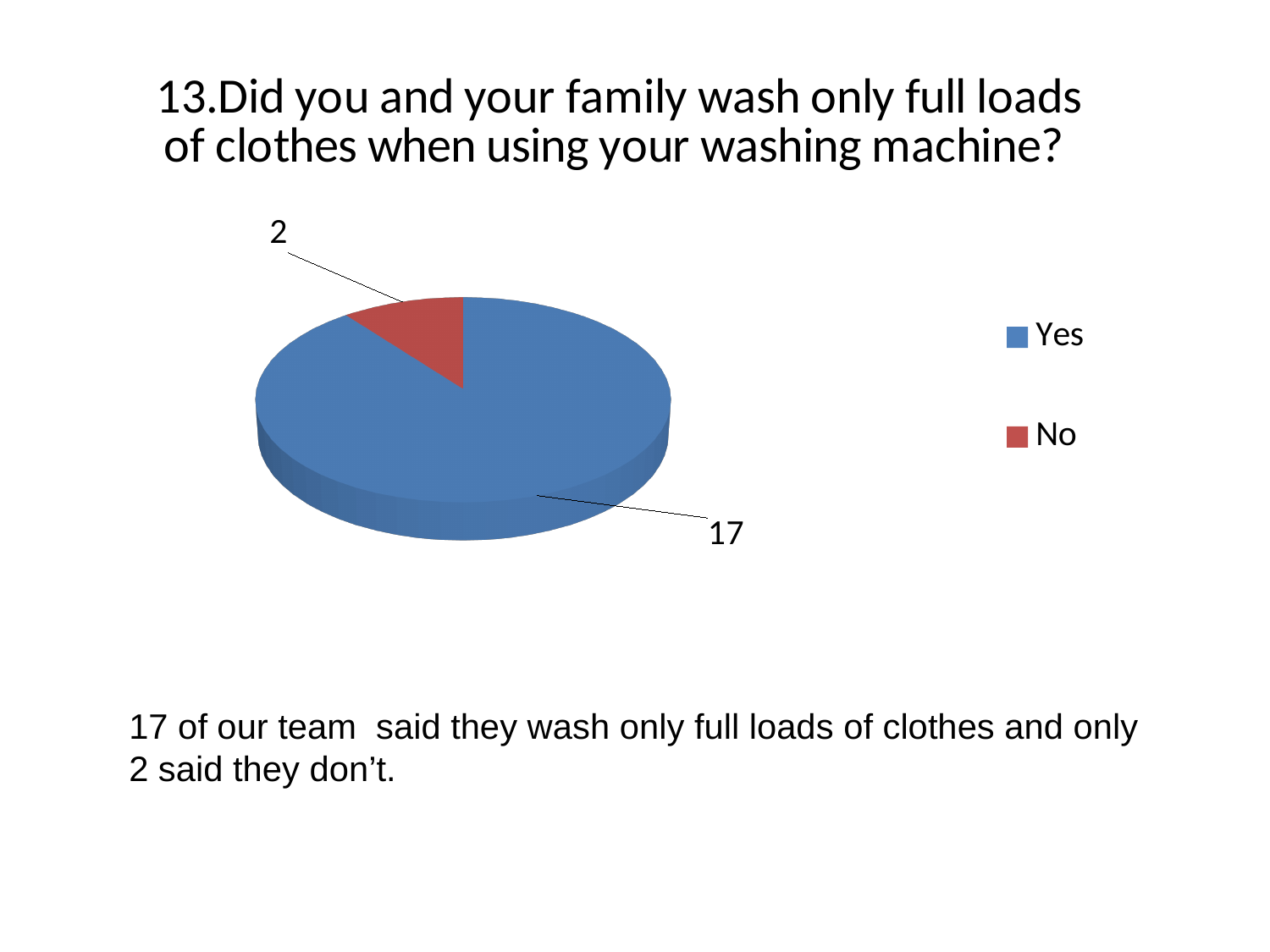
How many slices does the pie chart have? 2 Which is larger, the number of Yes responses or the number of No responses? Yes How many people answered Yes? 17 What colour is the No slice of the pie? red Which response has the largest slice of the pie? Yes How many people answered No? 2 What is the total number of responses shown in the pie chart? 19 What colour is the Yes slice of the pie? blue What kind of chart is shown on the slide? pie chart How many entries does the legend list? 2 How many more people answered Yes than No? 15 Which response has the smallest slice of the pie? No